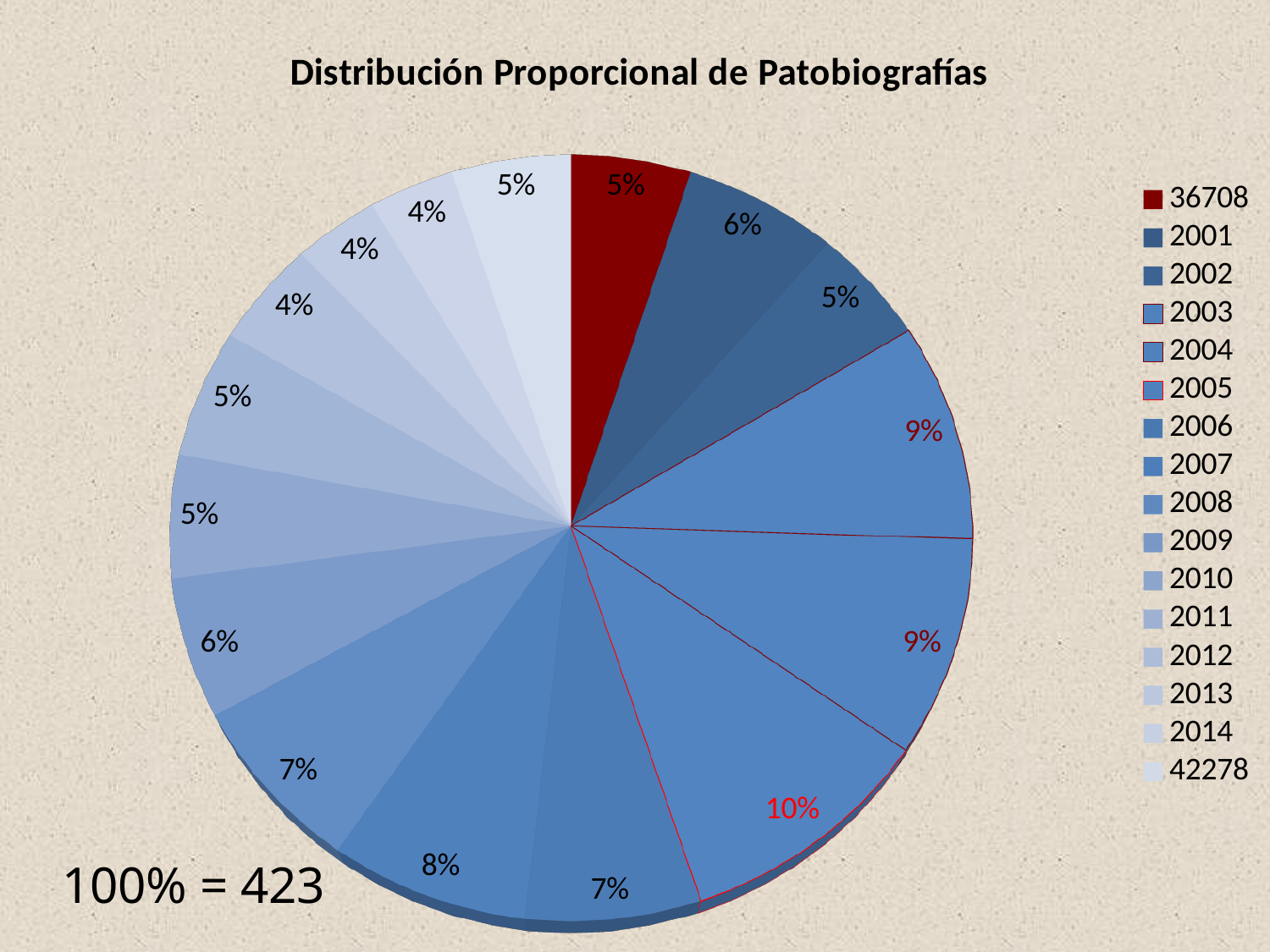
What is the value shown for 2001? 6% How many slices does the pie chart have? 16 What is the title of the chart? Distribución Proporcional de Patobiografías What is the value shown for 2010? 5% What share of the pie does the 2005 slice represent? 10% What is the difference in percentage points between the 2005 slice and the 2001 slice? 4 percentage points What kind of chart is shown on the slide? Pie chart What is the value shown for 2003? 9% What is the value shown for 2007? 8% Which category has the largest slice of the pie? 2005 Which is larger, the slice for 2005 or the slice for 2001? 2005 According to the text on the slide, what total count does 100% correspond to? 423